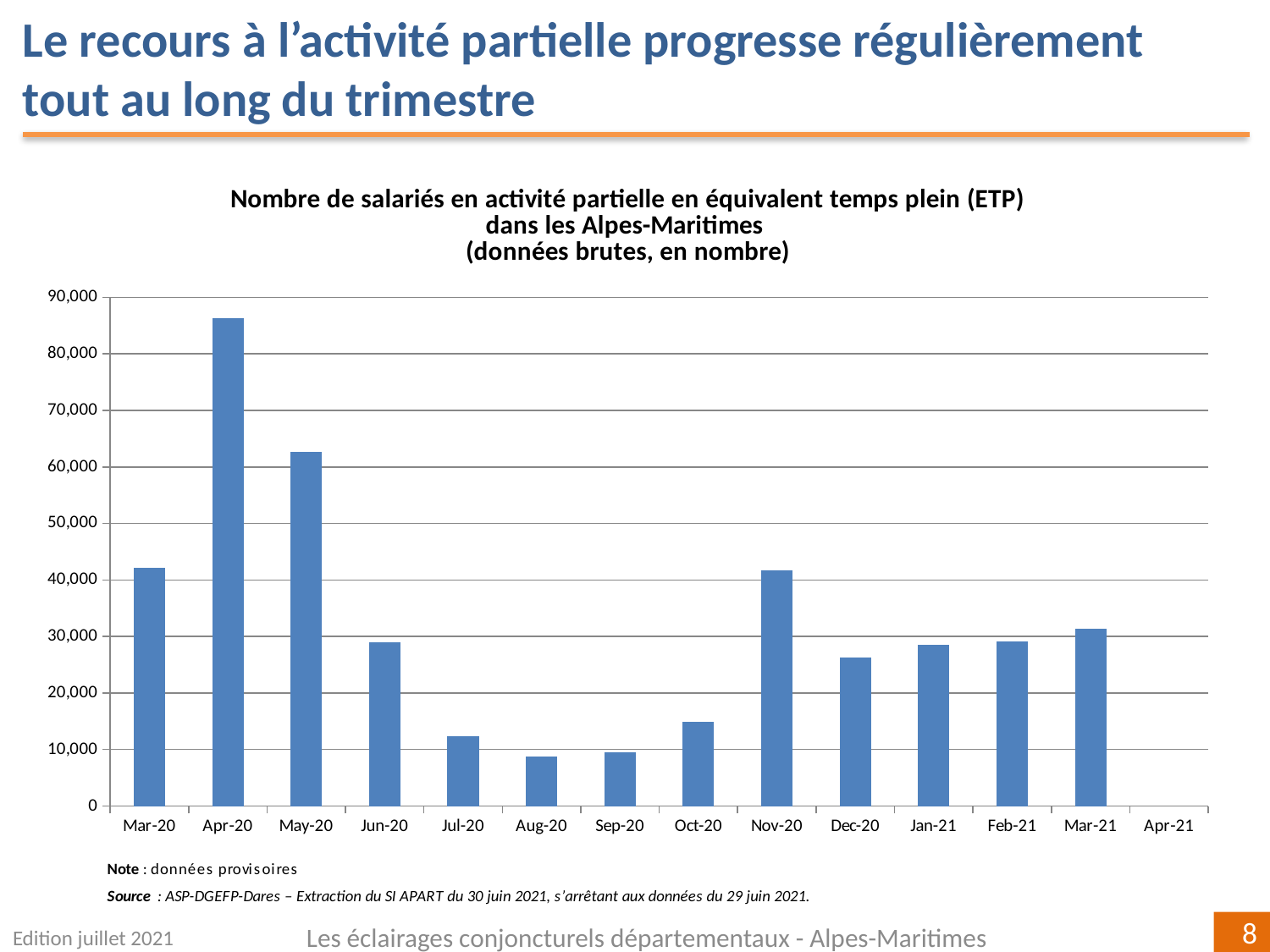
What kind of chart is shown on the slide? bar chart Is the value for Oct-20 greater or less than 20,000? less Which département does the chart title say the data refers to? Alpes-Maritimes Which is larger, the value for Apr-20 or the value for May-20? Apr-20 Is the value for Dec-20 greater or less than 30,000? less Is the value for Nov-20 greater or less than 40,000? greater How many months are labelled on the x axis? 14 Which month has the highest number of salariés en activité partielle (ETP)? Apr-20 Which is larger, the value for Nov-20 or the value for Dec-20? Nov-20 Do the values rise or fall from Dec-20 to Mar-21? rise